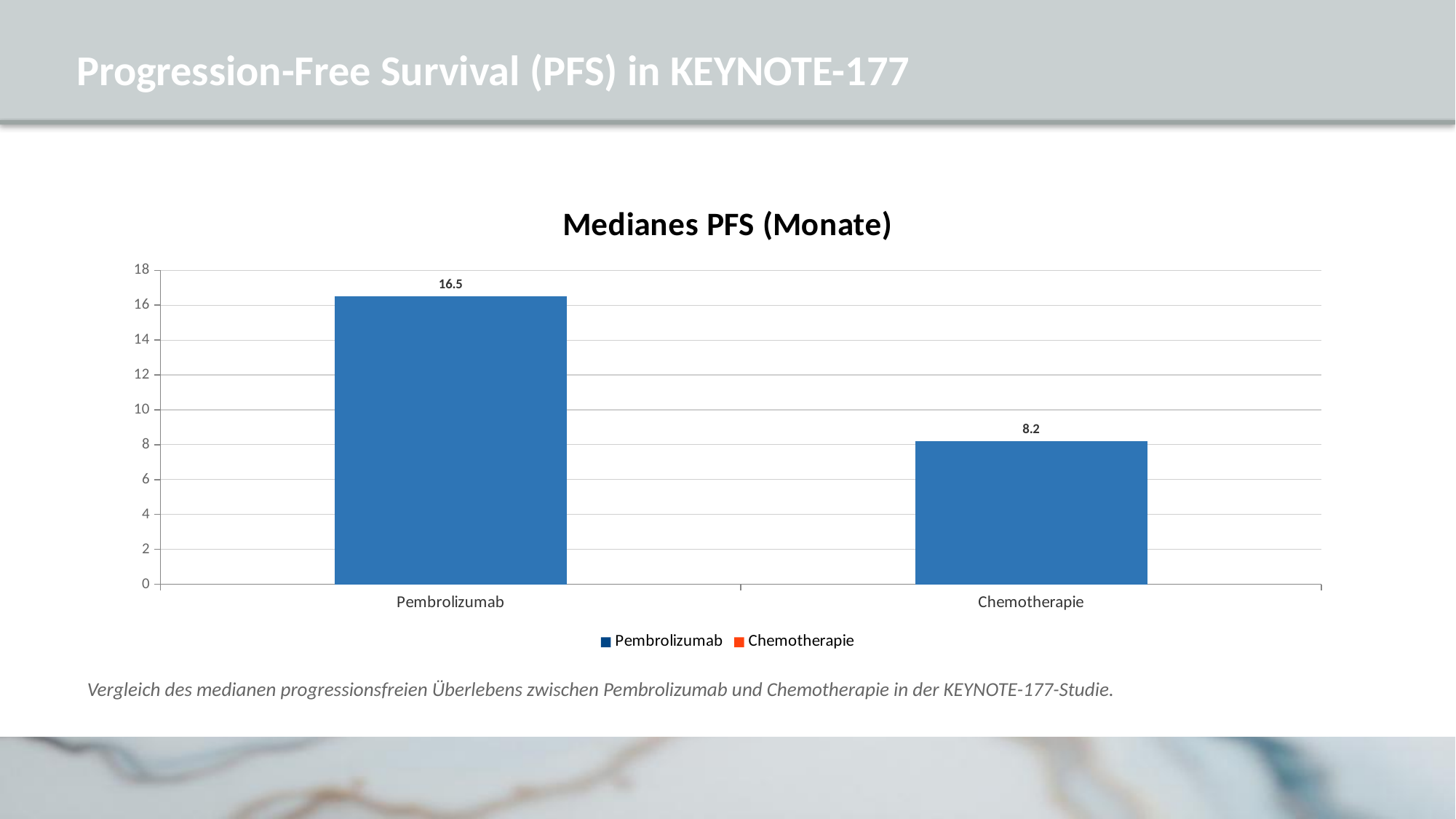
Which is larger, the median PFS for Pembrolizumab or for Chemotherapie? Pembrolizumab What is the median PFS value shown for Pembrolizumab? 16.5 Is the value for Pembrolizumab greater or less than 14? greater What is the title of the chart? Medianes PFS (Monate) Is the value for Chemotherapie greater or less than 10? less How many series does the legend list? 2 What kind of chart is shown on the slide? Bar chart Which category has the lowest median PFS? Chemotherapie Which category has the highest median PFS? Pembrolizumab How many categories are shown on the x axis of the chart? 2 What is the difference between the median PFS for Pembrolizumab and Chemotherapie? 8.3 What is the median PFS value shown for Chemotherapie? 8.2